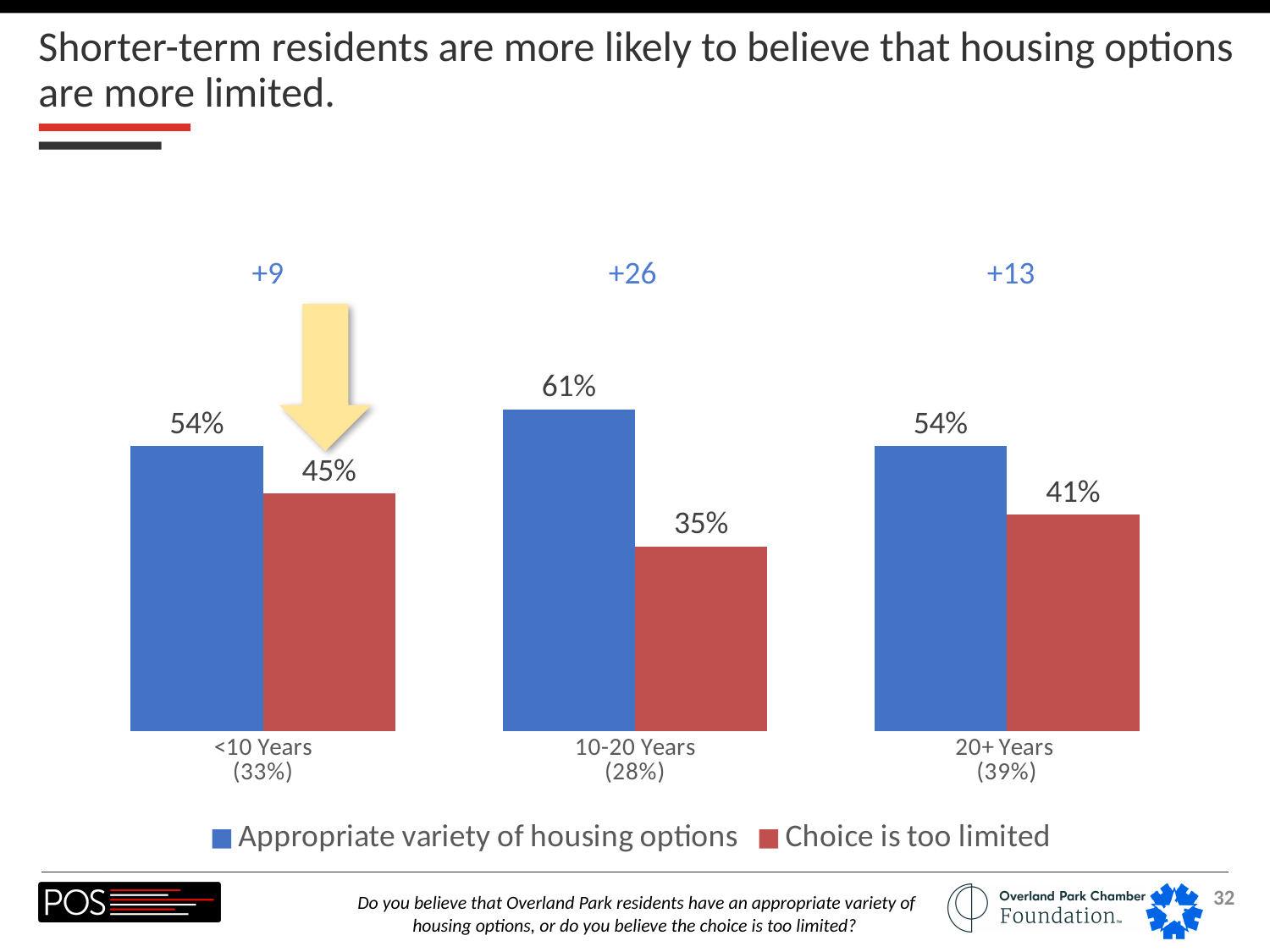
Which colour represents 'Choice is too limited' in the legend? Red What share of the sample is in the 20+ Years group, as shown in the category label? 39% What kind of chart is shown on the slide? Bar chart What percentage of residents of 20+ Years say the choice is too limited? 41% What percentage of residents of 10-20 Years say the choice is too limited? 35% How many residency groups are shown on the x axis? 3 Which residency group has the lowest share saying the choice is too limited? 10-20 Years Which residency group has the highest share saying there is an appropriate variety of housing options? 10-20 Years How many series does the legend list? 2 What percentage of residents of <10 Years say there is an appropriate variety of housing options? 54% For 20+ Years, which is larger: 'Appropriate variety of housing options' or 'Choice is too limited'? Appropriate variety of housing options What is the difference between the 'Appropriate variety of housing options' and 'Choice is too limited' values for 10-20 Years? 26